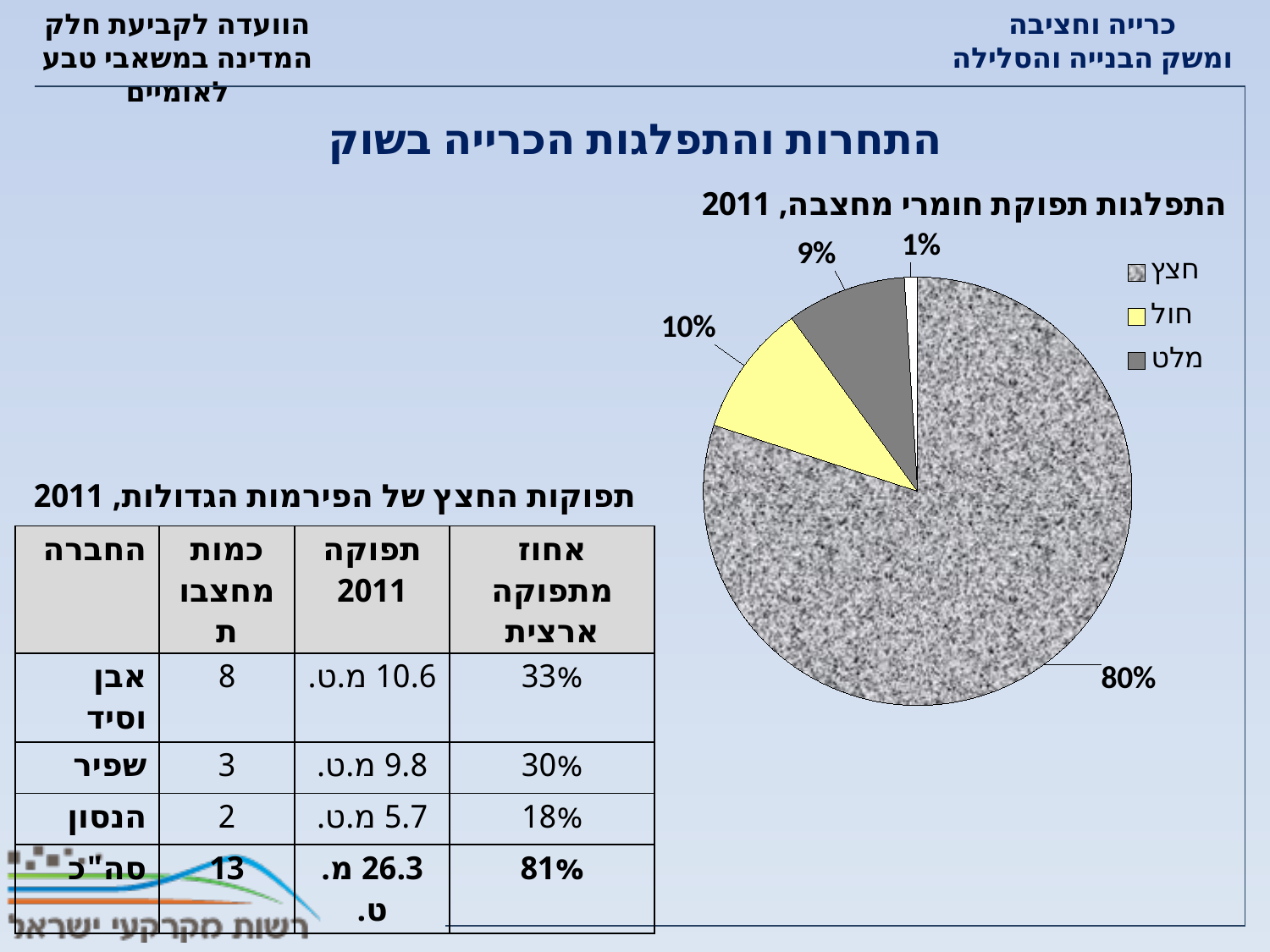
What is the difference between the share of חצץ and the share of חול in the pie chart? 70% What is the smallest percentage labelled on the pie chart? 1% How many entries does the pie chart's legend list? 3 What is the title of the pie chart? התפלגות תפוקת חומרי מחצבה, 2011 What percentage is shown for מלט in the pie chart? 9% How many slices does the pie chart have? 4 What type of chart is shown on the slide? pie chart What percentage is shown for חול in the pie chart? 10% What colour is the חול slice in the pie chart? yellow Which has a larger share in the pie chart, חול or מלט? חול What share of the pie chart does חצץ account for? 80% Which category has the largest slice in the pie chart? חצץ